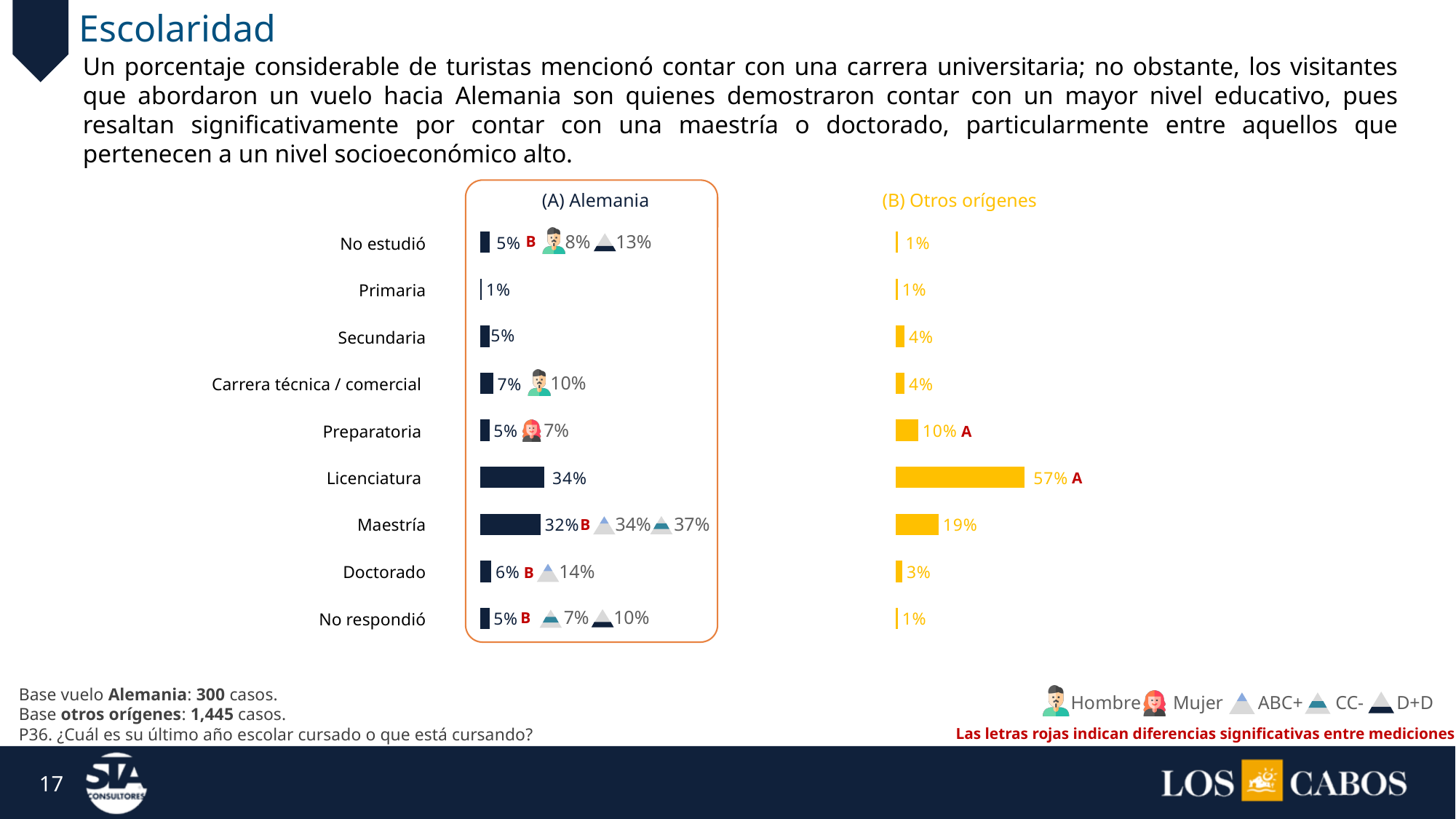
In the (B) Otros orígenes chart, what is the value for Maestría? 19% In the (B) Otros orígenes chart, what is the value for Licenciatura? 57% In the (A) Alemania chart, what is the value for Licenciatura? 34% How many education categories are listed in the charts? 9 What kind of chart is used to show the (A) Alemania data? Bar chart In the (A) Alemania chart, which category has the lowest value? Primaria In the (A) Alemania chart, what is the difference between Licenciatura and Maestría? 2 percentage points In the (B) Otros orígenes chart, which category has the highest value? Licenciatura Which chart shows a larger value for Doctorado, (A) Alemania or (B) Otros orígenes? (A) Alemania What is the difference between the Licenciatura values in the (B) Otros orígenes chart and the (A) Alemania chart? 23 percentage points In the (A) Alemania chart, what is the value for Maestría? 32% What is the base (number of cases) for the Alemania flight group? 300 casos